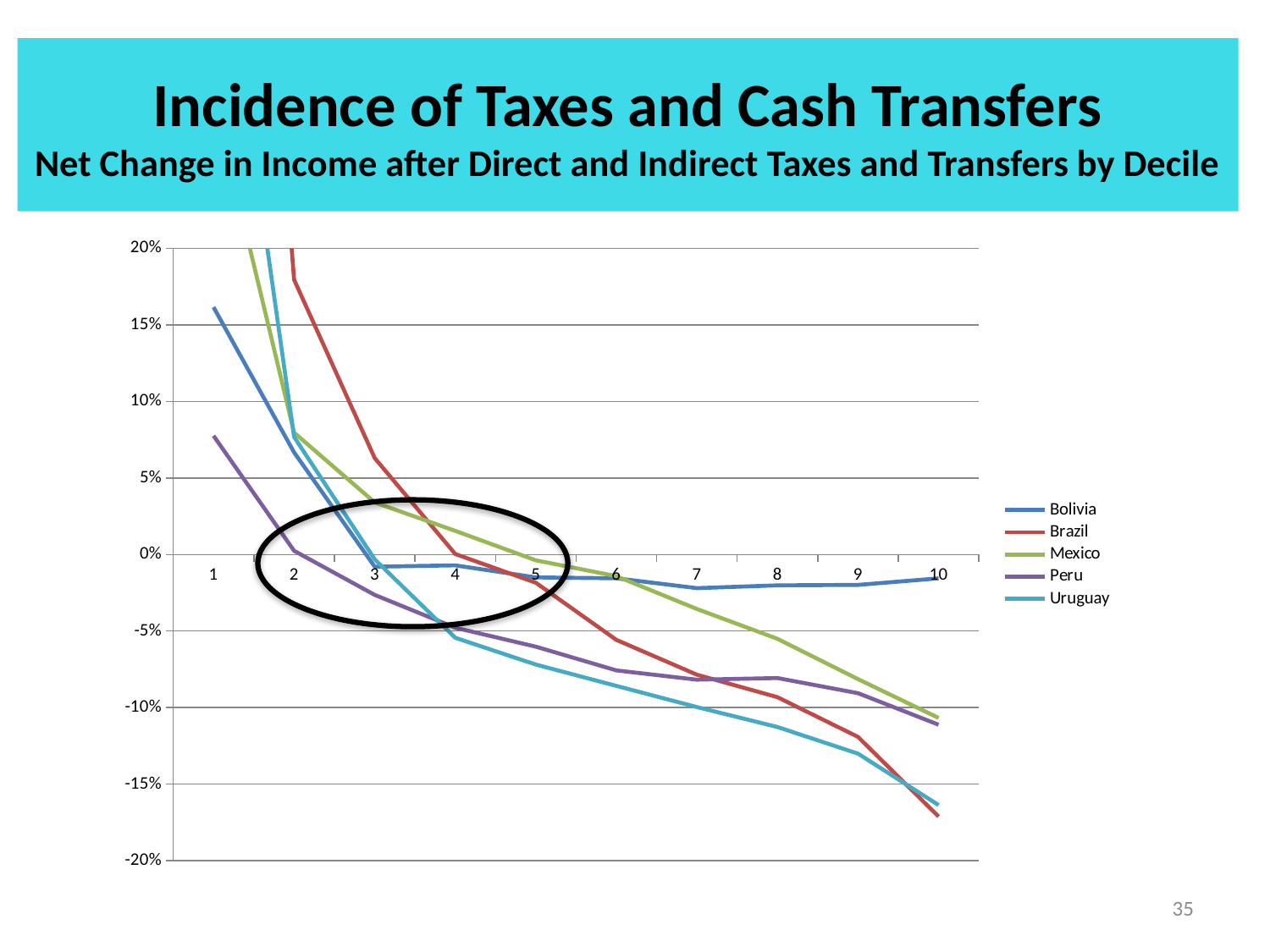
What kind of chart is shown on the slide? line chart Is the value for Brazil at decile 10 greater or less than -15%? less At decile 7, which is larger, the value for Bolivia or the value for Uruguay? Bolivia Is the value for Peru at decile 10 greater or less than -15%? greater What is the subtitle of the chart on the slide? Net Change in Income after Direct and Indirect Taxes and Transfers by Decile At decile 10, which is larger, the value for Bolivia or the value for Brazil? Bolivia How many deciles are plotted along the x axis? 10 Is the value for Bolivia at decile 1 greater or less than 10%? greater Does the Brazil line rise or fall from decile 2 to decile 10? fall Which country has the highest value at decile 10? Bolivia How many series does the legend list? 5